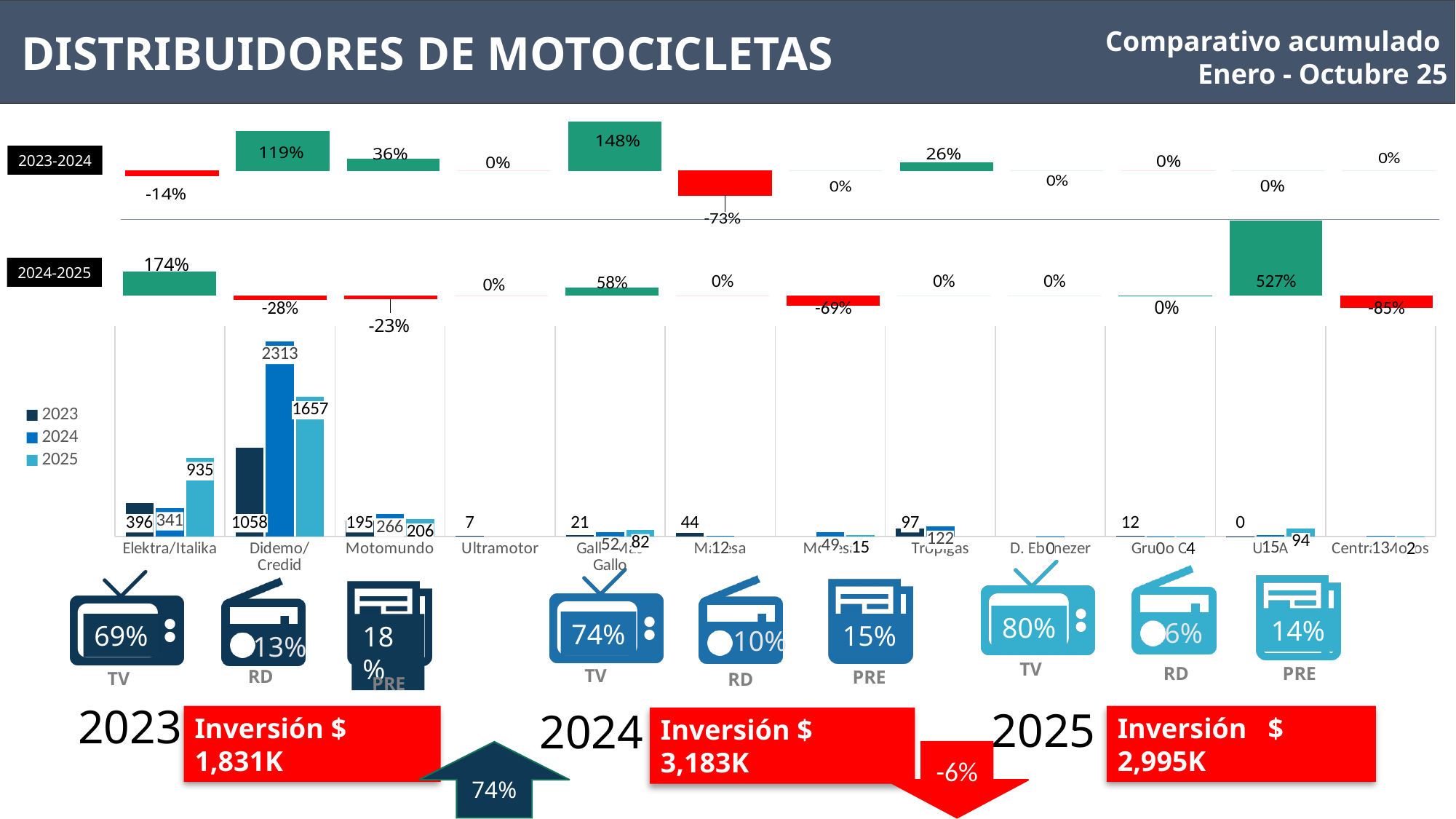
What kind of chart is the bottom chart showing 2023, 2024 and 2025 values per distributor? Bar chart In the bottom bar chart, what is the 2025 value for Elektra/Italika? 935 In the bottom bar chart, what is the 2024 value for Didemo/Credid? 2313 In the 2024-2025 chart, what is the percentage shown for Motomundo? -23% How many series does the legend of the bottom bar chart list? 3 In the 2024-2025 chart, what is the percentage shown for Elektra/Italika? 174% In the bottom bar chart, what is the difference between the 2024 and 2025 values for Didemo/Credid? 656 In the 2023-2024 chart at the top, what is the percentage shown for Didemo/Credid? 119% In the bottom bar chart, what is the 2023 value for Motomundo? 195 In the 2023-2024 chart at the top, what is the percentage shown for Motomundo? 36% In the bottom bar chart, which distributor has the highest 2024 value? Didemo/Credid In the bottom bar chart, which is larger for Motomundo: the 2024 value or the 2025 value? 2024